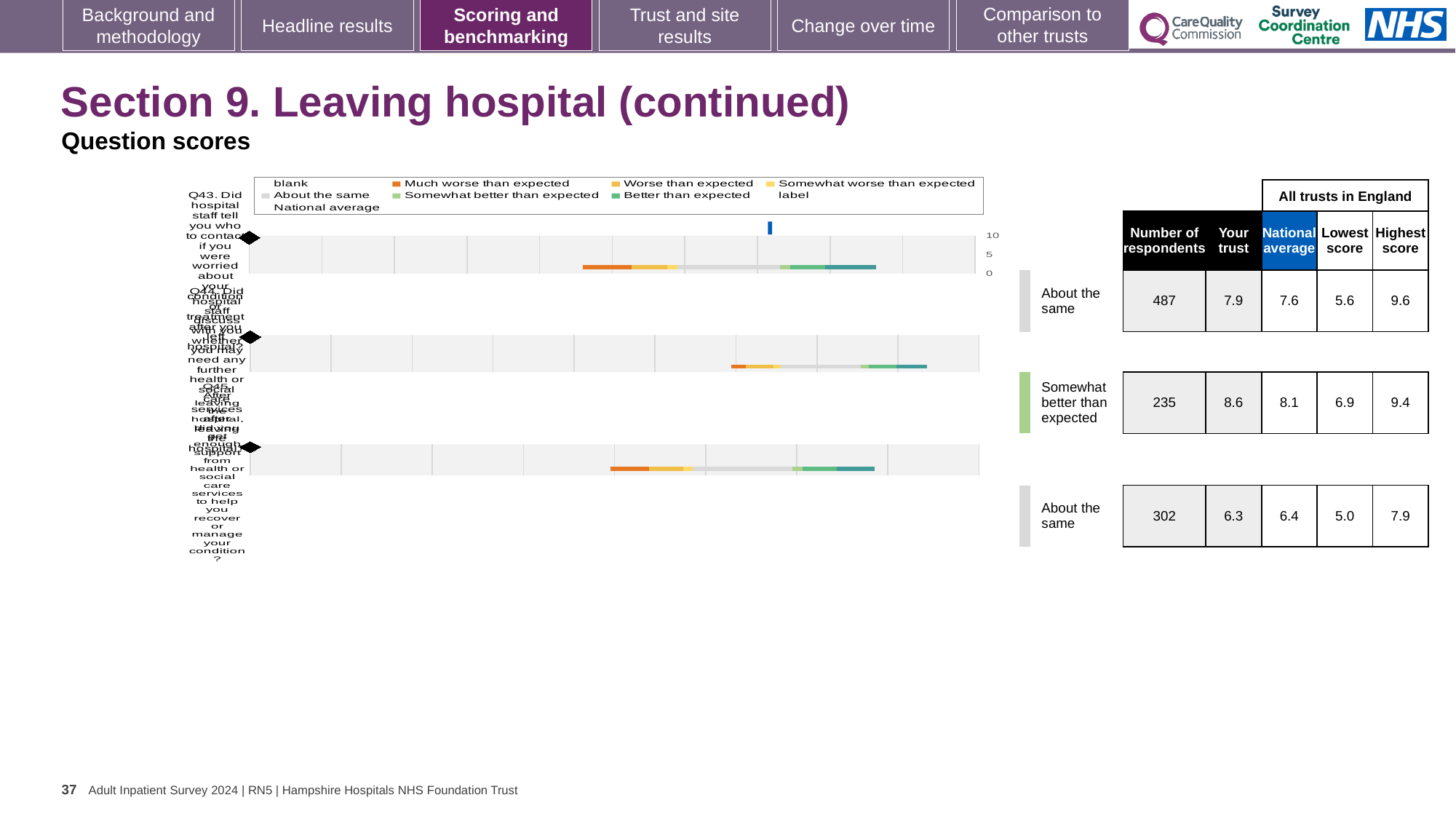
How many question rows are plotted in the chart? 3 What is the 'Your trust' score for the first row (Q43)? 7.9 What is the number of respondents for the second row? 235 Which row has the highest 'Your trust' score? The second row (8.6) For the first row (Q43), which is larger: the 'Your trust' score or the national average? Your trust Which row has the lowest number of respondents? The second row (235) For the second row, what is the difference between the highest score and the lowest score? 2.5 How many entries does the chart legend list? 9 What kind of chart is shown on the slide? Bar chart What is the title of the slide? Section 9. Leaving hospital (continued) What is the national average for the third row? 6.4 What benchmark category is shown for the second row? Somewhat better than expected